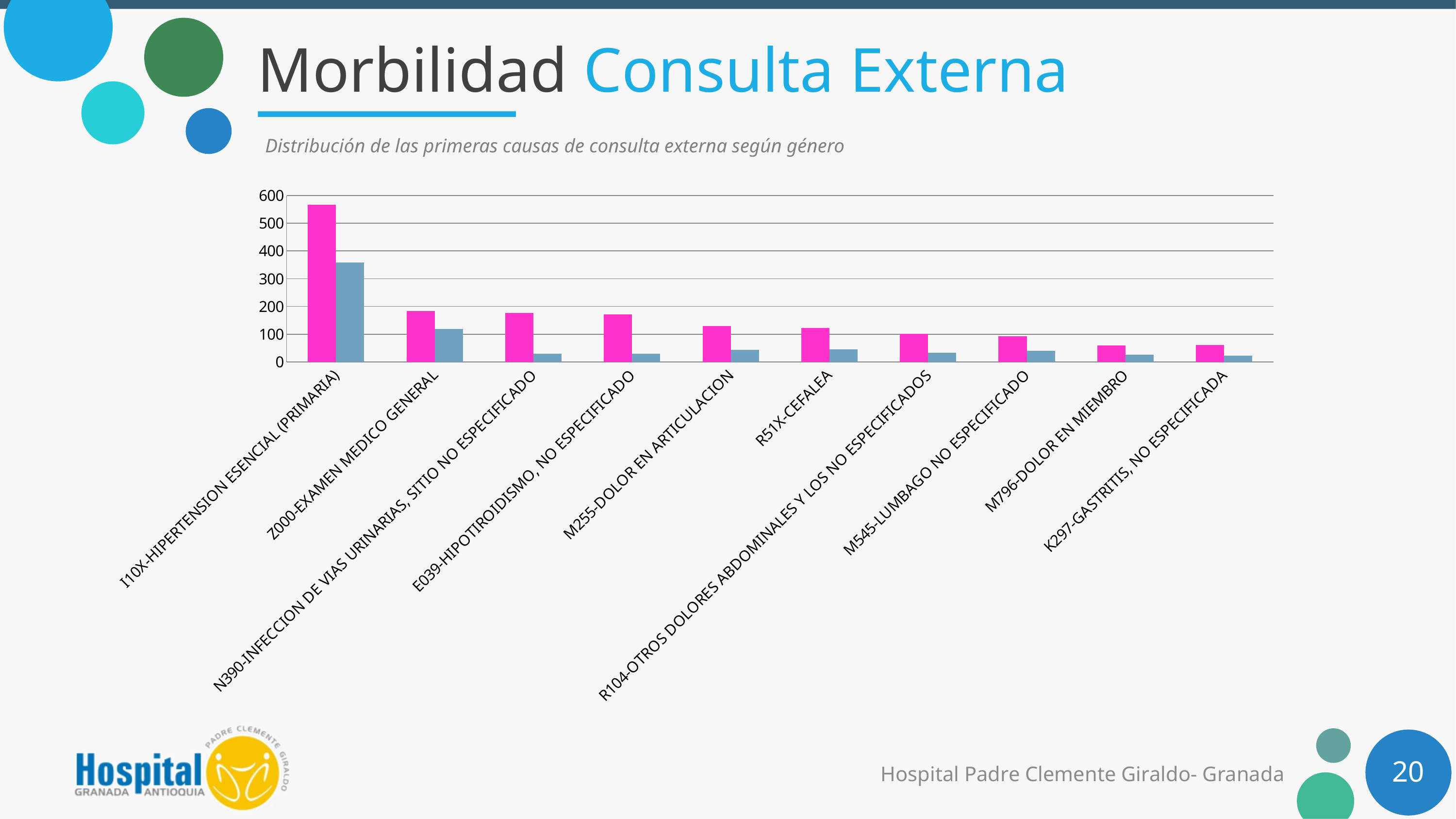
Is the pink bar for I10X-HIPERTENSION ESENCIAL (PRIMARIA) greater or less than 500? greater Is the blue-grey bar for I10X-HIPERTENSION ESENCIAL (PRIMARIA) greater or less than 300? greater Is the blue-grey bar for N390-INFECCION DE VIAS URINARIAS, SITIO NO ESPECIFICADO greater or less than 100? less What is the subtitle printed above the chart? Distribución de las primeras causas de consulta externa según género Which category has the highest pink bar in the chart? I10X-HIPERTENSION ESENCIAL (PRIMARIA) How many diagnosis categories are shown on the x axis of the chart? 10 Do the pink bars generally rise or fall moving from left to right along the x axis? fall For I10X-HIPERTENSION ESENCIAL (PRIMARIA), which bar is larger, the pink one or the blue-grey one? the pink one What kind of chart is shown on the slide? bar chart